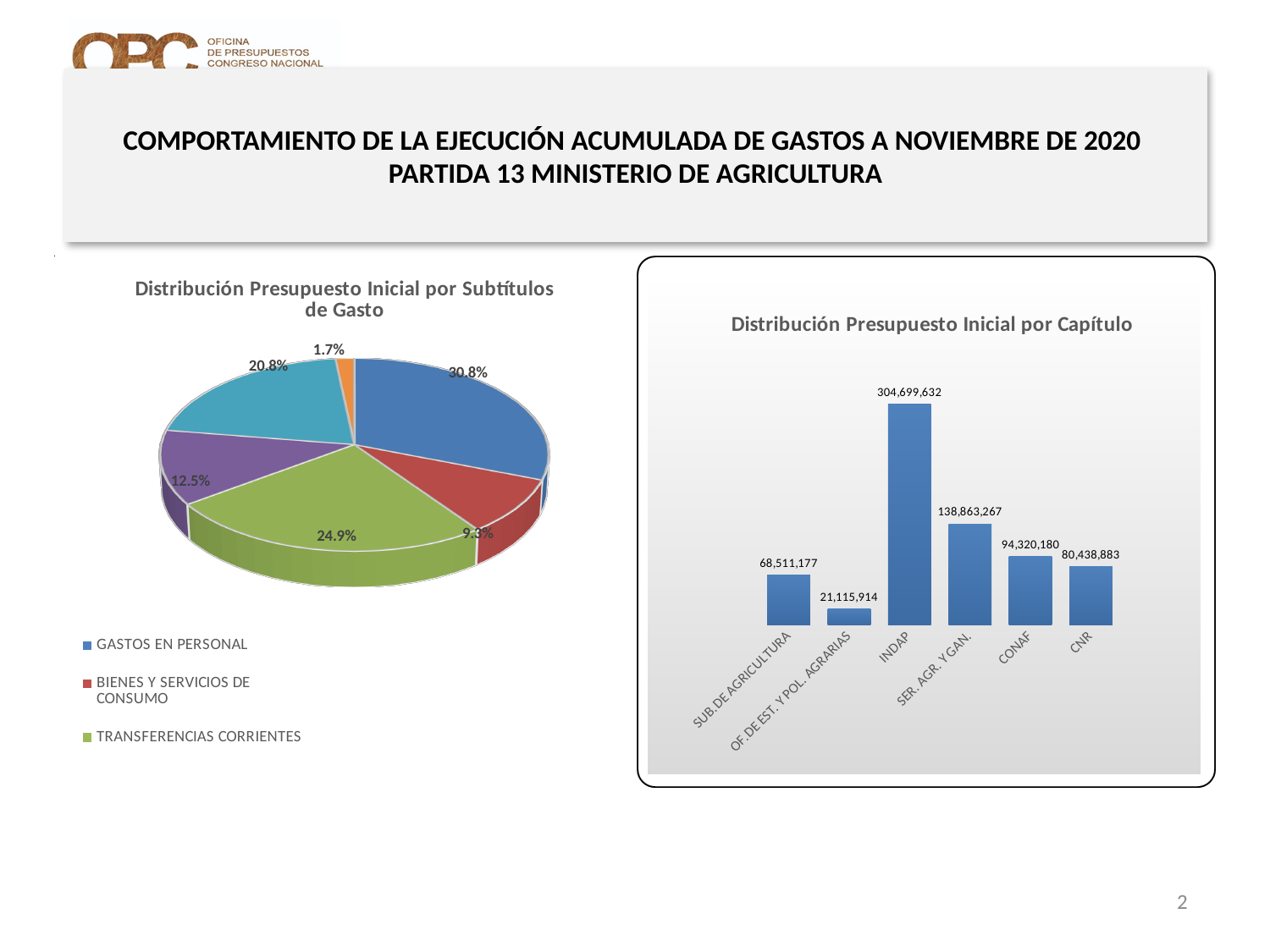
In the 'Distribución Presupuesto Inicial por Capítulo' chart, which category has the highest value? INDAP How many categories are shown in the 'Distribución Presupuesto Inicial por Capítulo' chart? 6 What kind of chart is 'Distribución Presupuesto Inicial por Capítulo'? Bar chart In the 'Distribución Presupuesto Inicial por Subtítulos de Gasto' chart, what share does GASTOS EN PERSONAL have? 30.8% In the 'Distribución Presupuesto Inicial por Capítulo' chart, what is the difference between the values for CONAF and CNR? 13,881,297 In the 'Distribución Presupuesto Inicial por Capítulo' chart, what is the value for INDAP? 304,699,632 In the 'Distribución Presupuesto Inicial por Subtítulos de Gasto' chart, which is larger, GASTOS EN PERSONAL or BIENES Y SERVICIOS DE CONSUMO? GASTOS EN PERSONAL In the 'Distribución Presupuesto Inicial por Capítulo' chart, which category has the lowest value? OF. DE EST. Y POL. AGRARIAS What kind of chart is 'Distribución Presupuesto Inicial por Subtítulos de Gasto'? Pie chart In the 'Distribución Presupuesto Inicial por Subtítulos de Gasto' chart, what share does TRANSFERENCIAS CORRIENTES have? 24.9% In the 'Distribución Presupuesto Inicial por Capítulo' chart, which is larger, SER. AGR. Y GAN. or SUB. DE AGRICULTURA? SER. AGR. Y GAN. In the 'Distribución Presupuesto Inicial por Capítulo' chart, what is the value for CONAF? 94,320,180